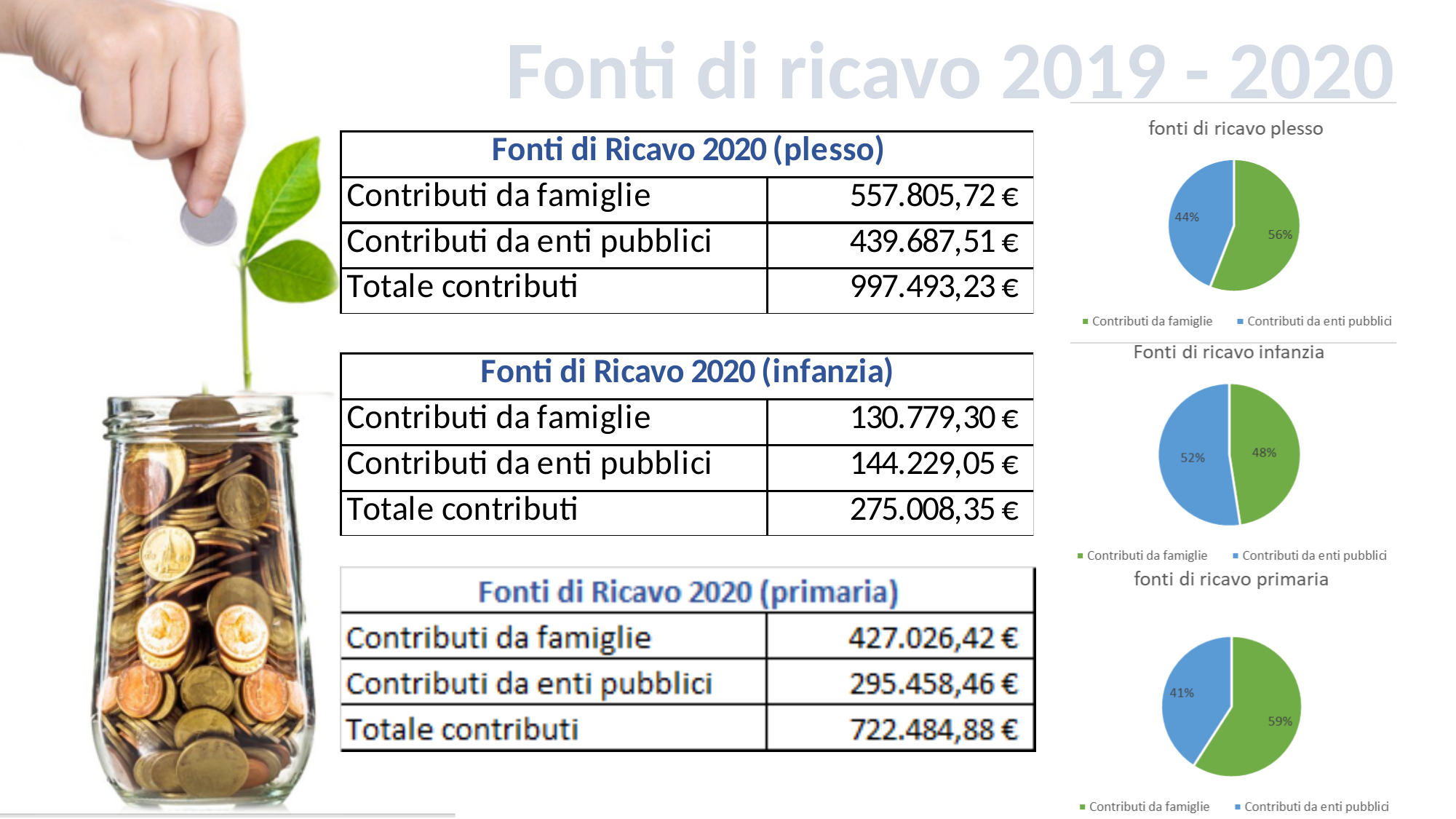
In the 'fonti di ricavo plesso' chart, what share of the pie is 'Contributi da enti pubblici'? 44% In the 'fonti di ricavo plesso' chart, what share of the pie is 'Contributi da famiglie'? 56% In the 'fonti di ricavo plesso' chart, what is the difference in percentage points between 'Contributi da famiglie' and 'Contributi da enti pubblici'? 12 In the 'fonti di ricavo primaria' chart, what share of the pie is 'Contributi da famiglie'? 59% In the 'Fonti di ricavo infanzia' chart, which colour represents 'Contributi da enti pubblici'? Blue What type of chart is 'fonti di ricavo plesso'? Pie chart In the 'Fonti di ricavo infanzia' chart, which slice is the smallest? Contributi da famiglie In the 'fonti di ricavo primaria' chart, which slice is the largest? Contributi da famiglie How many slices does the 'fonti di ricavo primaria' pie chart have? 2